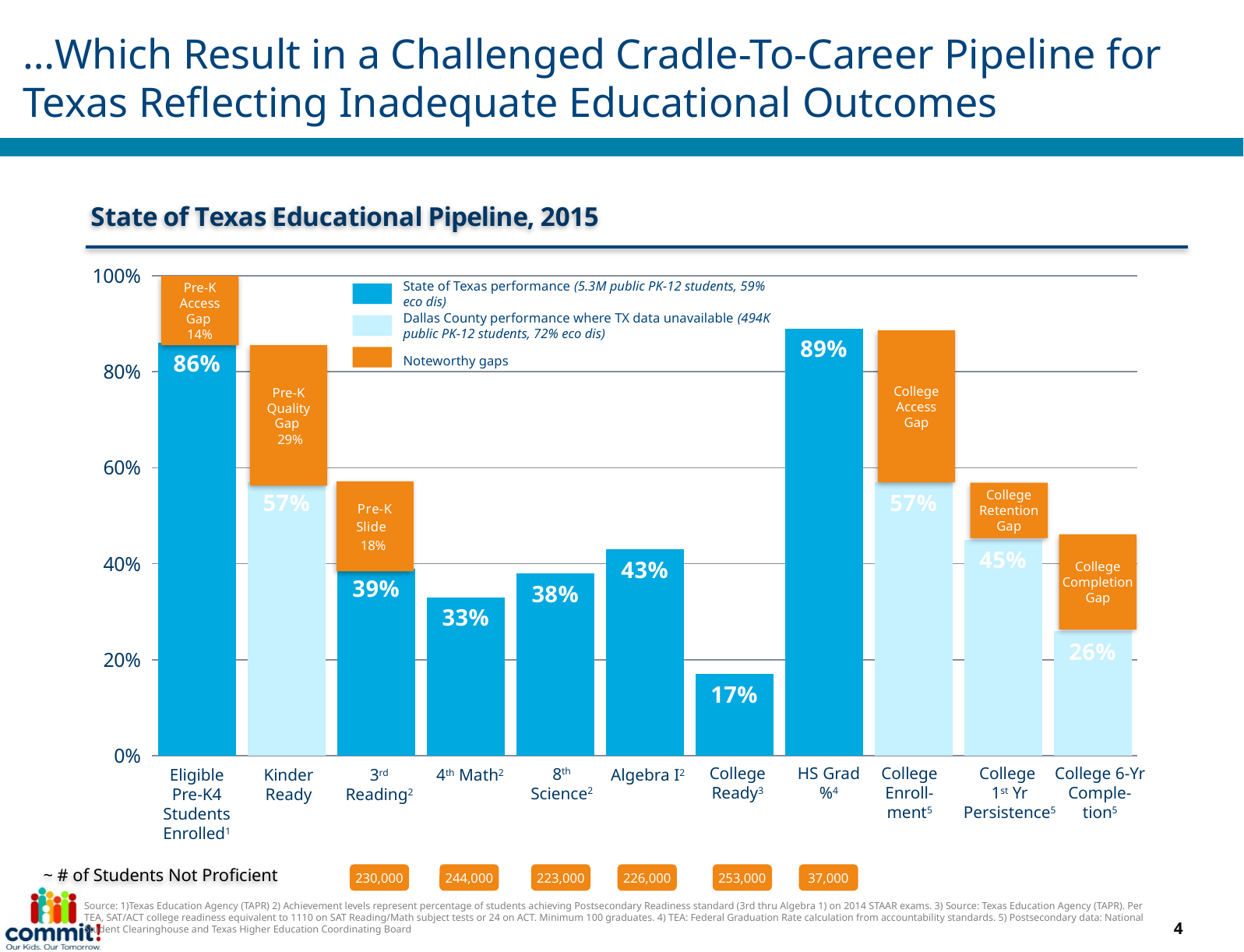
How many categories are shown along the x axis of the State of Texas Educational Pipeline chart? 11 What is the value for College Ready in the State of Texas Educational Pipeline chart? 17% How many entries does the legend of the State of Texas Educational Pipeline chart list? 3 What is the value for 4th Math in the State of Texas Educational Pipeline chart? 33% Which category has the lowest value in the State of Texas Educational Pipeline chart? College Ready Which is larger, the value for Algebra I or the value for 8th Science? Algebra I What is the value for HS Grad % in the State of Texas Educational Pipeline chart? 89% What is the difference between the Eligible Pre-K4 Students Enrolled value and the Kinder Ready value? 29% What is the value for College 6-Yr Completion in the State of Texas Educational Pipeline chart? 26% What percentage is shown for the Pre-K Quality Gap in the State of Texas Educational Pipeline chart? 29% What kind of chart is the State of Texas Educational Pipeline, 2015? Bar chart Which category has the highest value in the State of Texas Educational Pipeline chart? HS Grad %